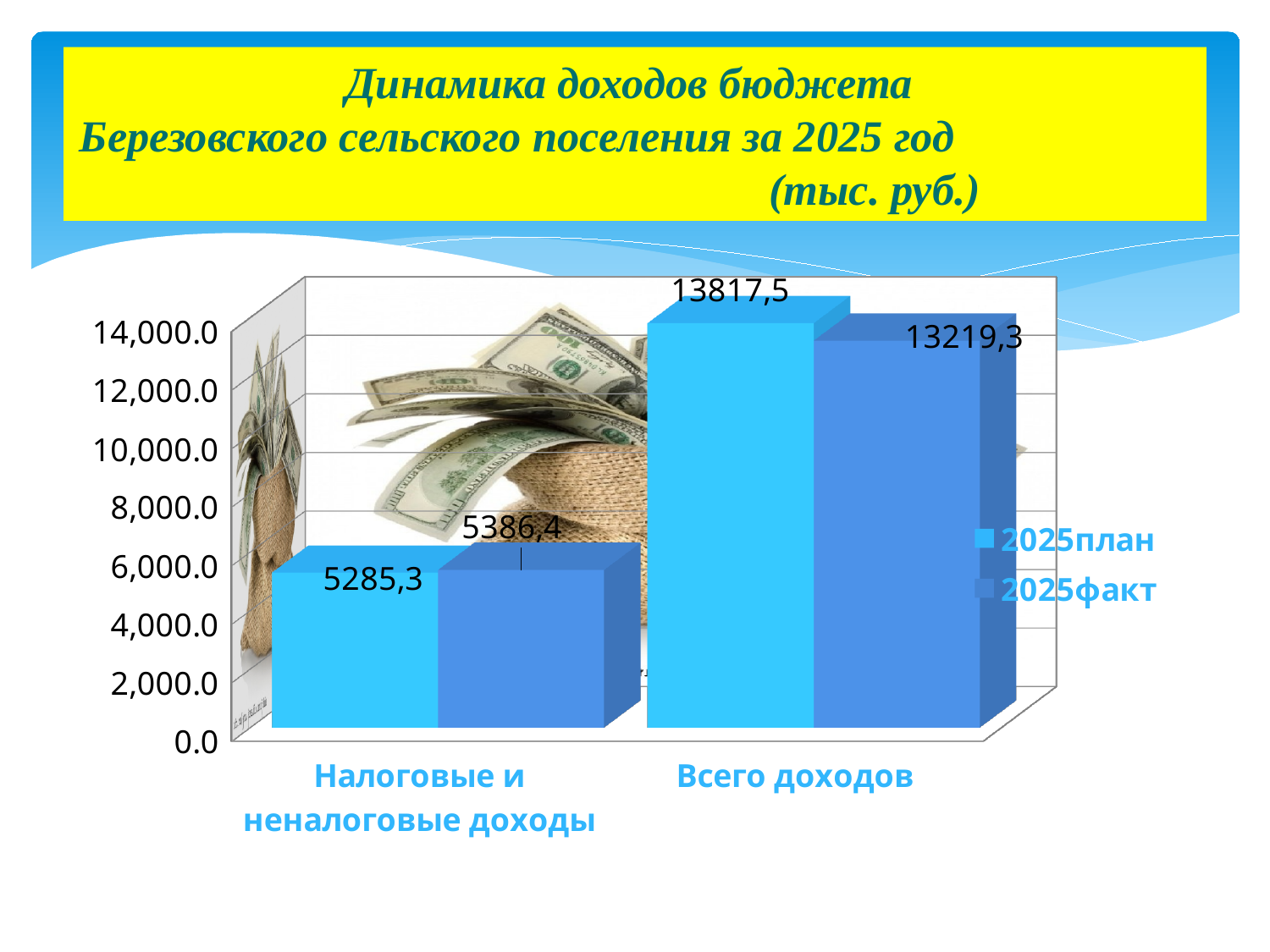
Which category has the lowest 2025факт value? Налоговые и неналоговые доходы What is the difference between the 2025план and 2025факт values for Всего доходов? 598,2 How many series does the chart legend list? 2 What is the 2025план value for Всего доходов? 13817,5 What is the 2025план value for Налоговые и неналоговые доходы? 5285,3 For Всего доходов, which is larger: the 2025план value or the 2025факт value? 2025план How many categories are shown on the x axis of the chart? 2 What is the 2025факт value for Всего доходов? 13219,3 Which category has the highest 2025план value? Всего доходов What kind of chart is shown on the slide? Bar chart What is the difference between the 2025факт and 2025план values for Налоговые и неналоговые доходы? 101,1 What is the 2025факт value for Налоговые и неналоговые доходы? 5386,4